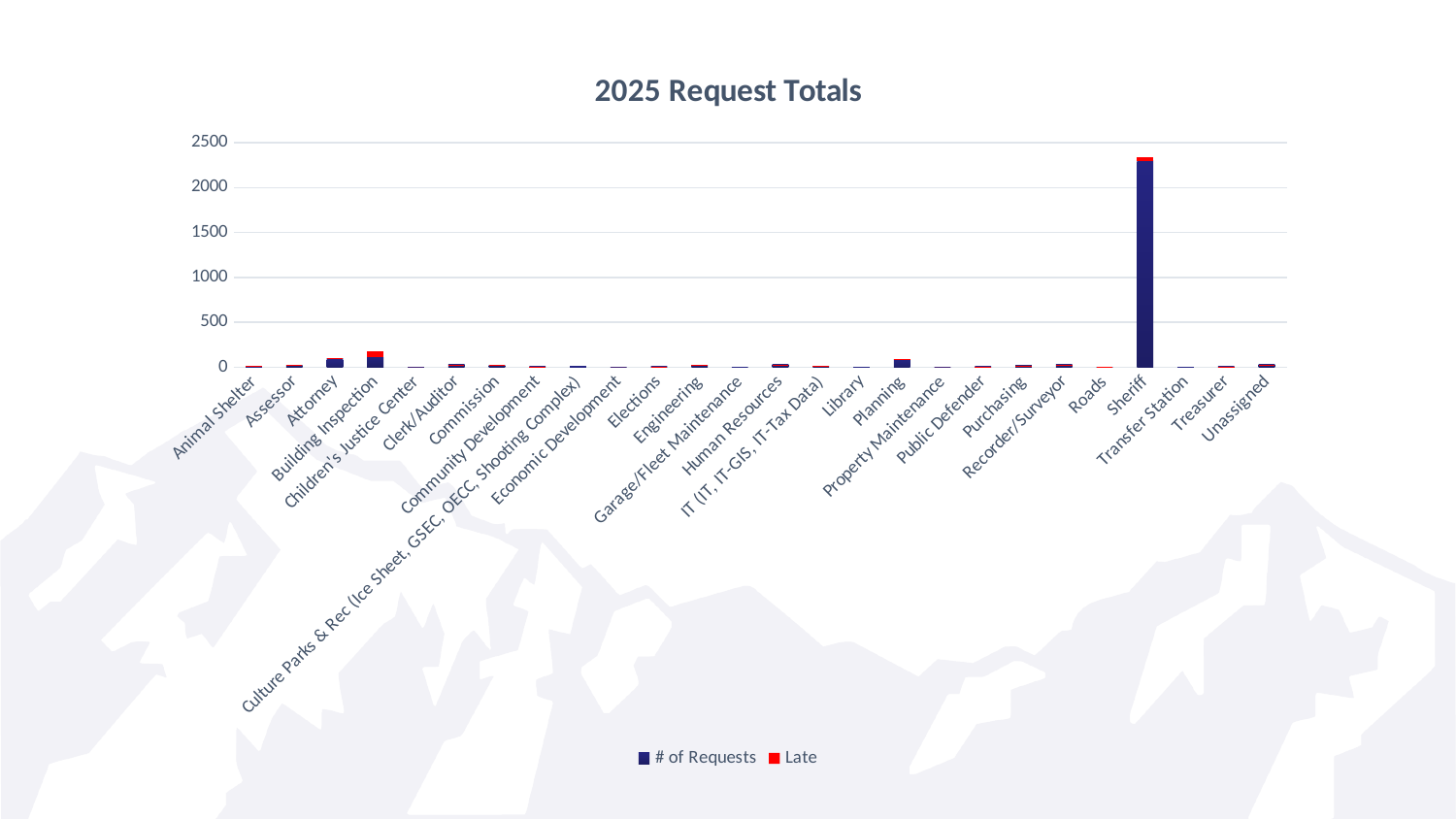
What is the title of the chart? 2025 Request Totals Which is larger, the total for Sheriff or the total for Building Inspection? Sheriff Is the value for Sheriff greater or less than 2000? greater Is the value for Attorney greater or less than 500? less What kind of chart is shown on the slide? bar chart Is the value for Sheriff greater or less than 2500? less How many series does the legend list? 2 What are the two series named in the legend? # of Requests and Late Which category has the highest total in the chart? Sheriff Which is larger, the total for Building Inspection or the total for Attorney? Building Inspection How many categories are shown along the x axis? 26